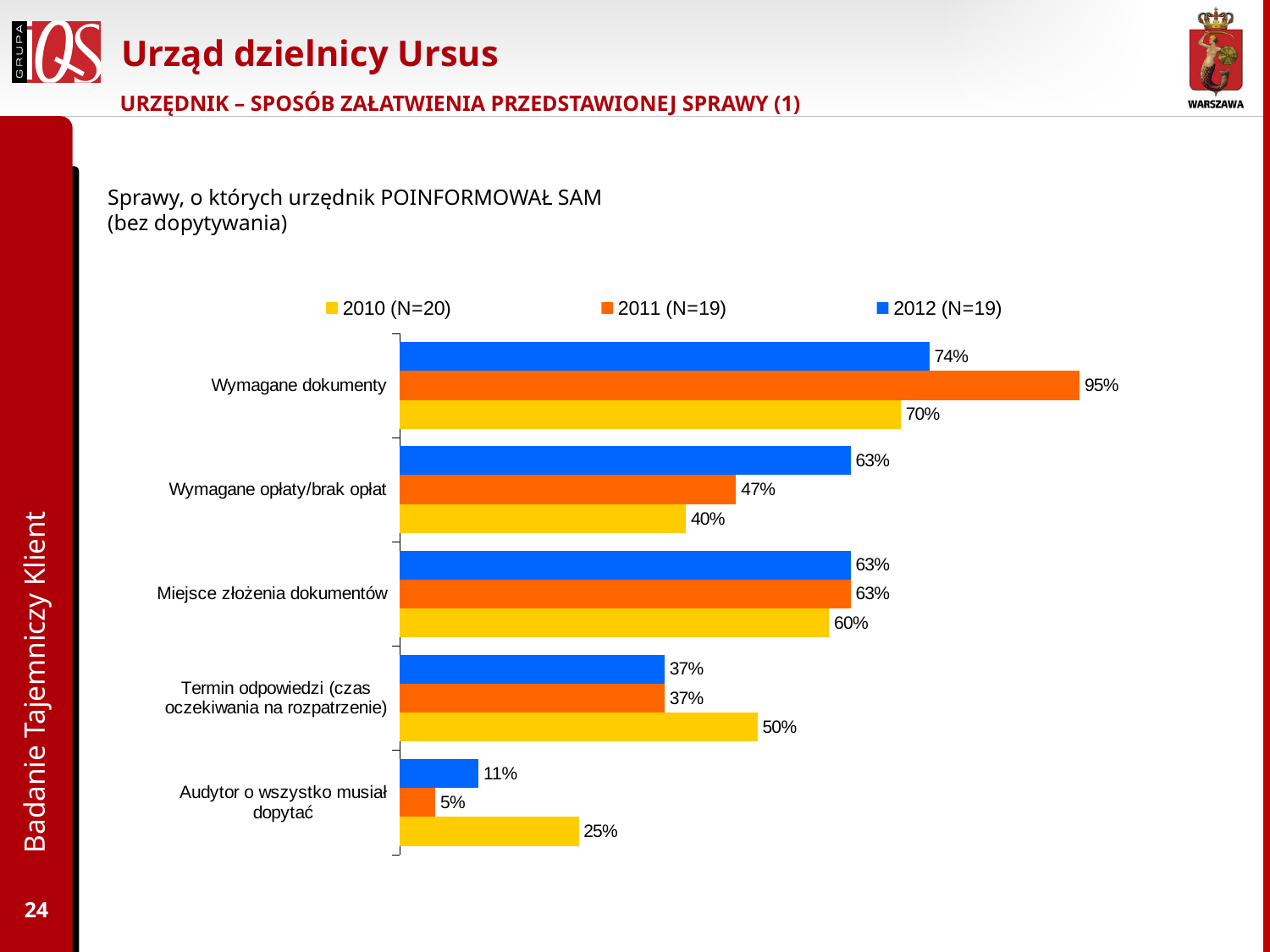
What kind of chart is shown on the slide? Bar chart What is the difference between the 2011 (N=19) and 2010 (N=20) values for 'Wymagane dokumenty'? 25% For 'Termin odpowiedzi (czas oczekiwania na rozpatrzenie)', which series has the larger value: 2010 (N=20) or 2012 (N=19)? 2010 (N=20) How many categories are shown on the chart? 5 Which colour represents the 2010 (N=20) series in the legend? Yellow Which category has the highest value in the 2012 (N=19) series? Wymagane dokumenty Which category has the lowest value in the 2011 (N=19) series? Audytor o wszystko musiał dopytać How many series does the legend list? 3 What is the value for 'Wymagane opłaty/brak opłat' in the 2010 (N=20) series? 40% What is the difference between the 2012 (N=19) and 2011 (N=19) values for 'Wymagane opłaty/brak opłat'? 16% What is the value for 'Audytor o wszystko musiał dopytać' in the 2012 (N=19) series? 11% What is the value for 'Wymagane dokumenty' in the 2011 (N=19) series? 95%